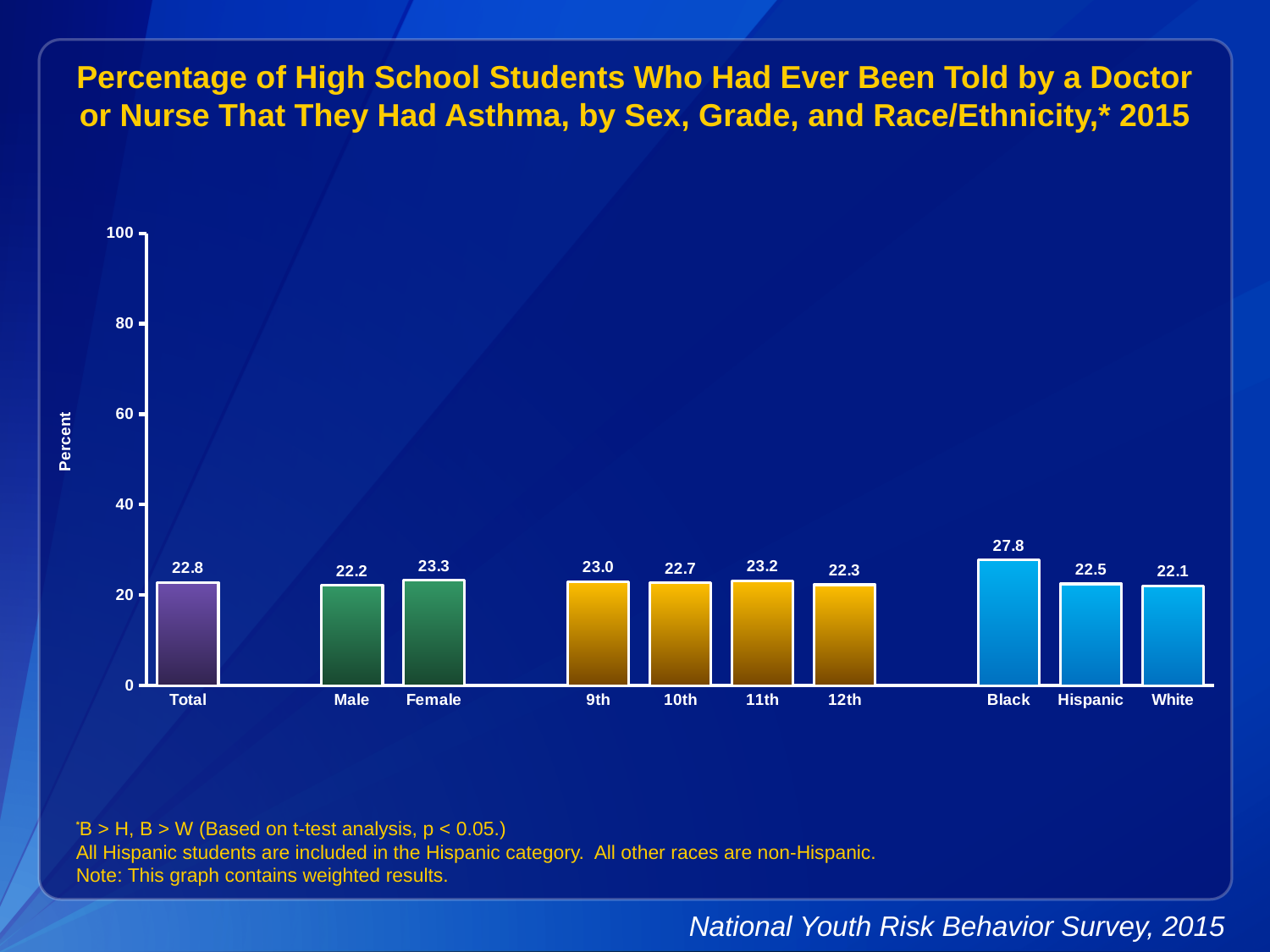
Which category has the highest value? Black What is the label of the y axis? Percent What is the difference between the values for Female and Male? 1.1 What is the value for Black? 27.8 Which category has the lowest value? White Which is larger, the value for Black or the value for White? Black What is the difference between the values for Black and Hispanic? 5.3 What kind of chart is shown on the slide? bar chart Is the value for Black greater or less than 40? less What is the value for Total? 22.8 What is the value for 11th grade? 23.2 How many bars are shown in the chart? 10